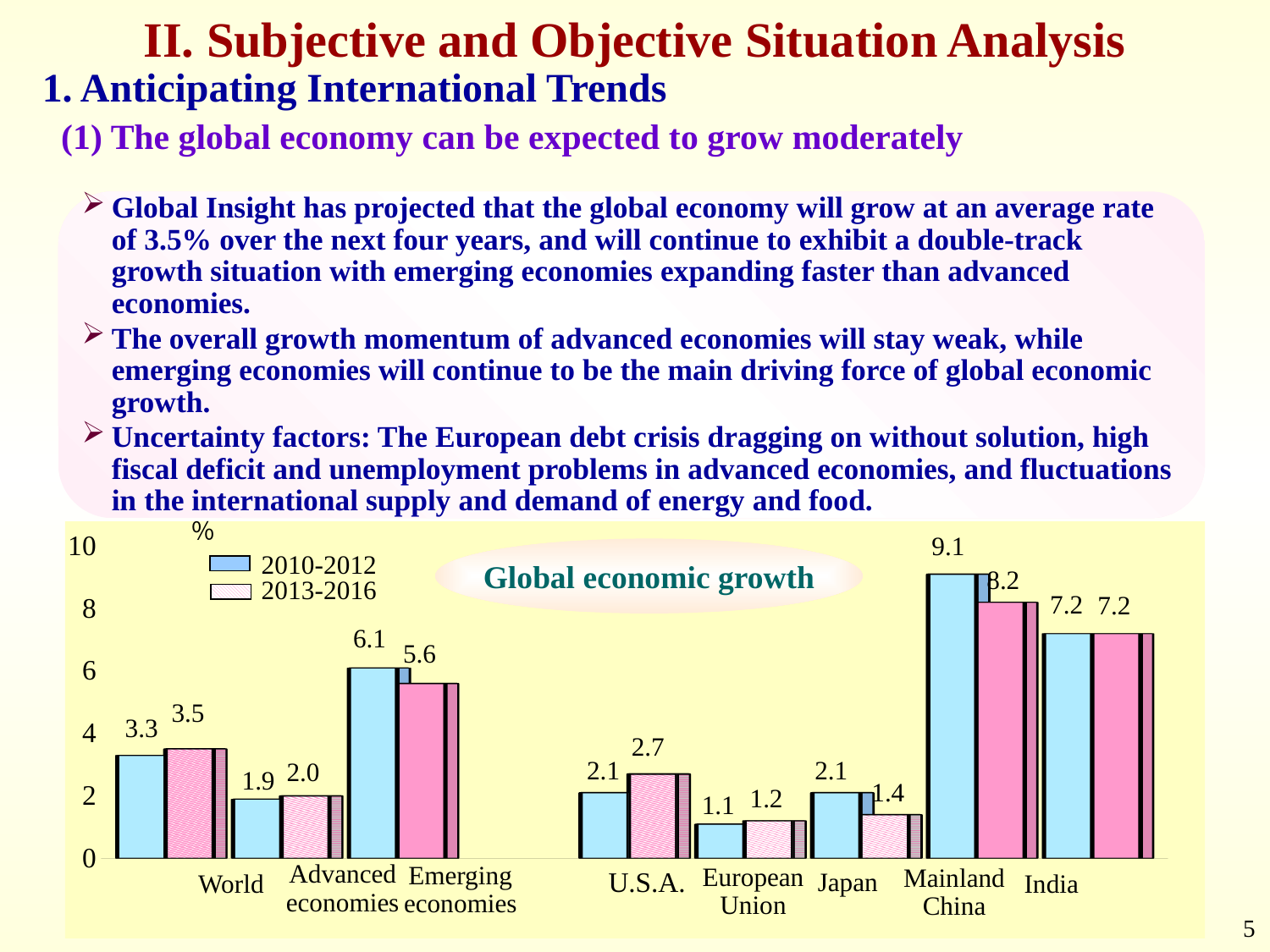
What is the difference between the 2010-2012 and 2013-2016 values for Mainland China? 0.9 Which is larger for Japan: the 2010-2012 value or the 2013-2016 value? 2010-2012 What is the title of the chart? Global economic growth Which category has the highest value in the 2010-2012 series? Mainland China What is the value for Mainland China in the 2010-2012 series? 9.1 What is the difference between the 2013-2016 values for U.S.A. and Japan? 1.3 Which category has the lowest value in the 2013-2016 series? European Union What is the value for Emerging economies in the 2013-2016 series? 5.6 What is the value for the European Union in the 2013-2016 series? 1.2 How many categories are shown on the x axis? 8 What kind of chart is shown on the slide? Bar chart How many series does the legend list? 2